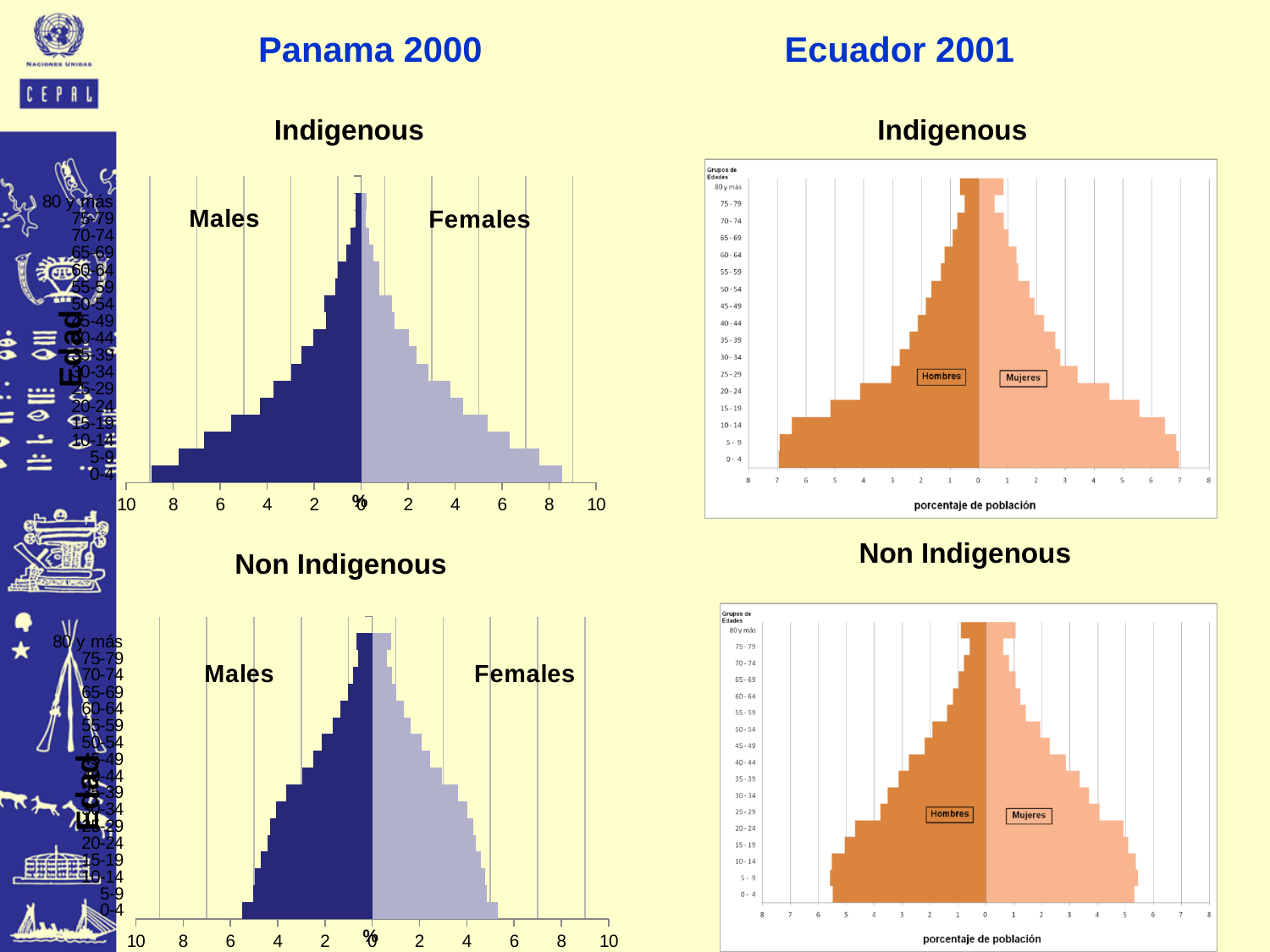
Which age group has the widest bars in the Panama 2000 Indigenous chart? 0-4 In the Panama 2000 Non Indigenous chart, is the value for Females aged 0-4 greater or less than 4? greater What is the x-axis title of the Ecuador 2001 Indigenous chart? porcentaje de población In the Ecuador 2001 Indigenous chart, is the value for Hombres aged 0-4 greater or less than 6? greater Is the Males 0-4 bar larger in the Panama 2000 Indigenous chart or in the Panama 2000 Non Indigenous chart? Panama 2000 Indigenous What kind of chart is the Panama 2000 Indigenous chart? bar chart (population pyramid) How many age groups are shown in the Ecuador 2001 Non Indigenous chart? 17 In the Panama 2000 Non Indigenous chart, is the value for Males aged 0-4 greater or less than 6? less In the Ecuador 2001 Indigenous chart, do the bars get wider or narrower as age increases from 0-4 to 80 y más? narrower